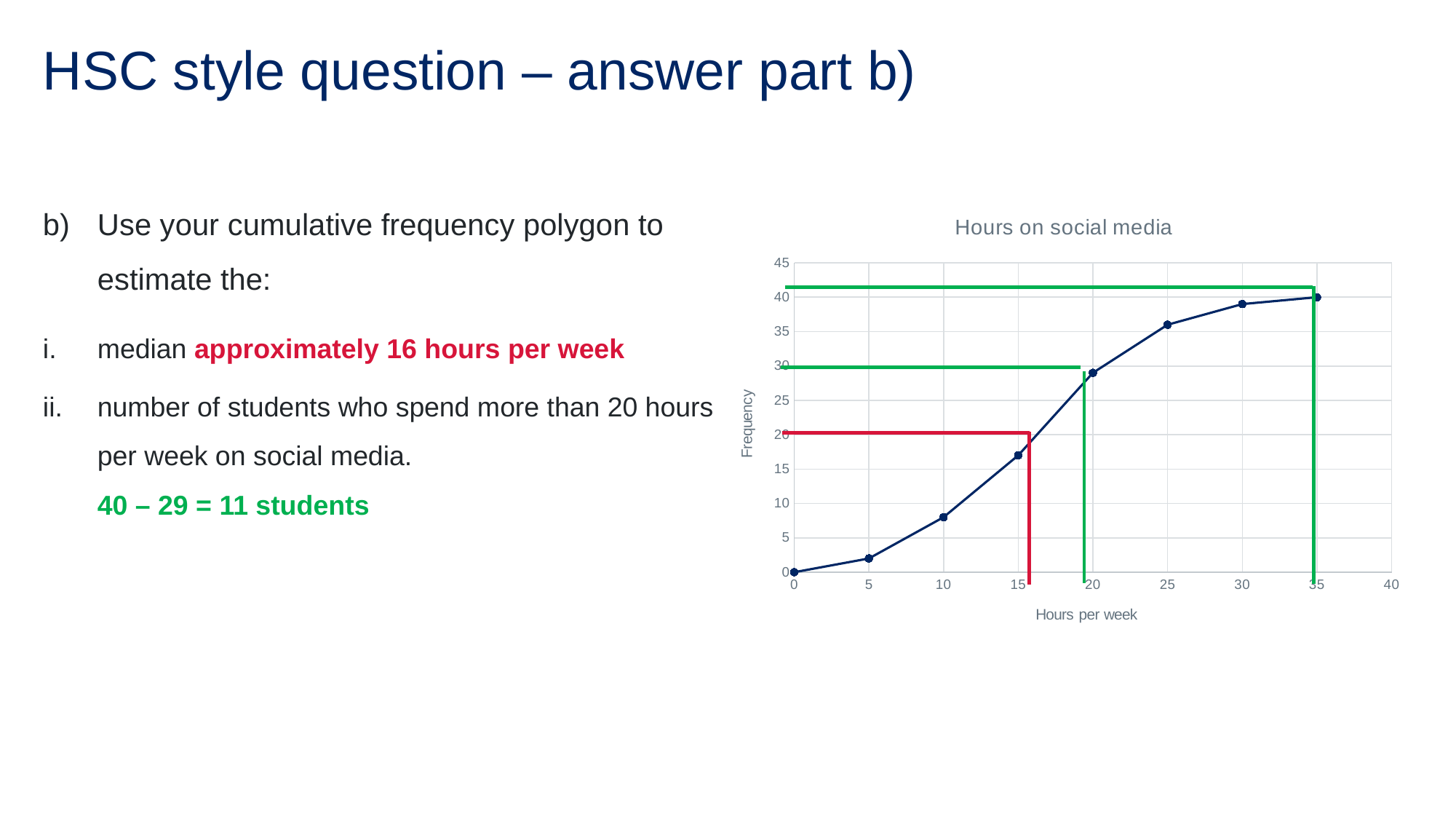
What is the cumulative frequency at 35 hours per week? 40 At which number of hours per week is the cumulative frequency lowest? 0 Is the cumulative frequency at 25 hours per week greater or less than 30? greater What is the cumulative frequency at 0 hours per week? 0 At which number of hours per week is the cumulative frequency highest? 35 Does the cumulative frequency rise or fall as hours per week increase? rise How many data points are plotted on the cumulative frequency polygon? 8 Which has the larger cumulative frequency: 15 hours per week or 20 hours per week? 20 hours per week Is the cumulative frequency at 10 hours per week greater or less than 10? less What is the label on the horizontal axis of the chart? Hours per week What type of chart is shown on the slide? line chart What is the title of the chart? Hours on social media